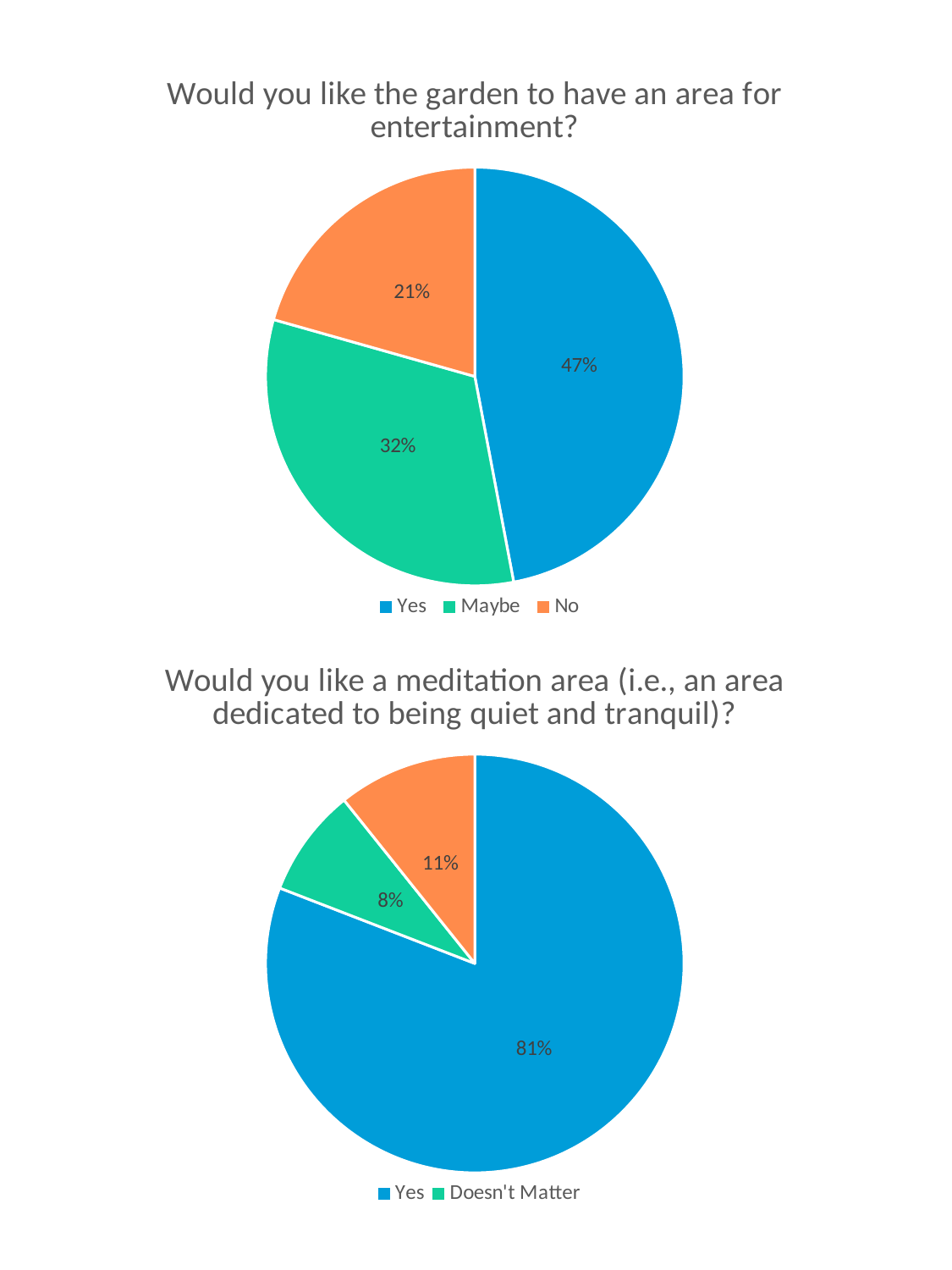
In the bottom chart, 'Would you like a meditation area?', what share of respondents answered Yes? 81% In the top chart, 'Would you like the garden to have an area for entertainment?', which response has the largest slice? Yes In the bottom chart, 'Would you like a meditation area?', how many percentage points larger is the Yes slice than the Doesn't Matter slice? 73 In the top chart, 'Would you like the garden to have an area for entertainment?', how many percentage points larger is the Yes slice than the No slice? 26 In the top chart, 'Would you like the garden to have an area for entertainment?', what share of respondents answered No? 21% In the top chart, 'Would you like the garden to have an area for entertainment?', what share of respondents answered Maybe? 32% In the top chart, 'Would you like the garden to have an area for entertainment?', which is larger, the Maybe slice or the No slice? Maybe What type of chart is used for both charts on the slide? Pie chart In the top chart, 'Would you like the garden to have an area for entertainment?', which response has the smallest slice? No In the bottom chart, 'Would you like a meditation area?', what share of respondents answered Doesn't Matter? 8% In the top chart, 'Would you like the garden to have an area for entertainment?', how many entries does the legend list? 3 In the top chart, 'Would you like the garden to have an area for entertainment?', what share of respondents answered Yes? 47%